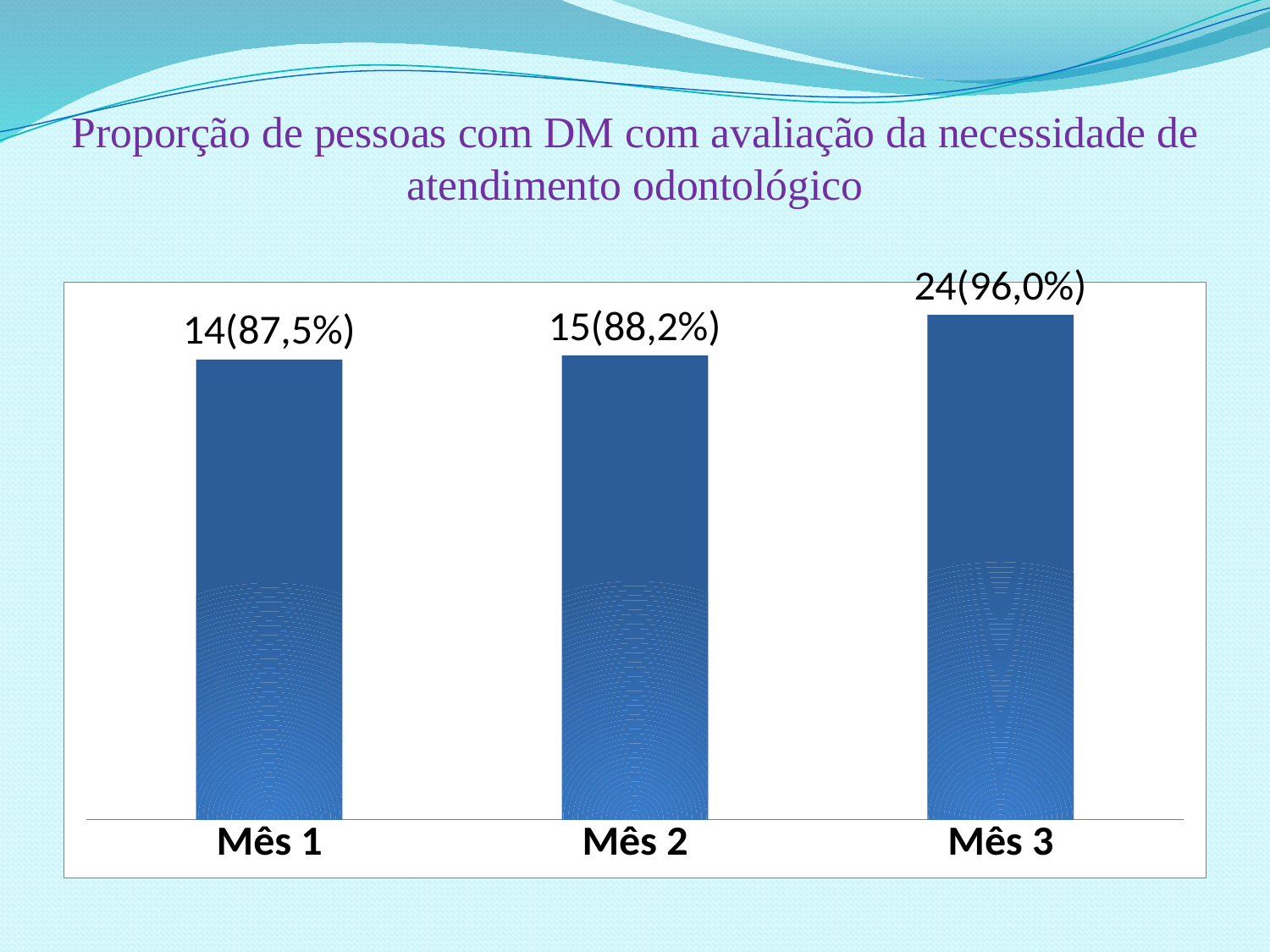
How many categories are shown on the x axis? 3 Which month has the lowest value? Mês 1 What is the data label shown for Mês 1? 14(87,5%) Which is larger, the value for Mês 1 or the value for Mês 3? Mês 3 What is the data label shown for Mês 3? 24(96,0%) By how many percentage points does Mês 3 exceed Mês 1? 8,5 What is the data label shown for Mês 2? 15(88,2%) What percentage is shown for Mês 3? 96,0% Do the values rise or fall from Mês 1 to Mês 3? Rise Which month has the highest value? Mês 3 What kind of chart is shown on the slide? Bar chart How many more people are counted in Mês 3 than in Mês 1? 10